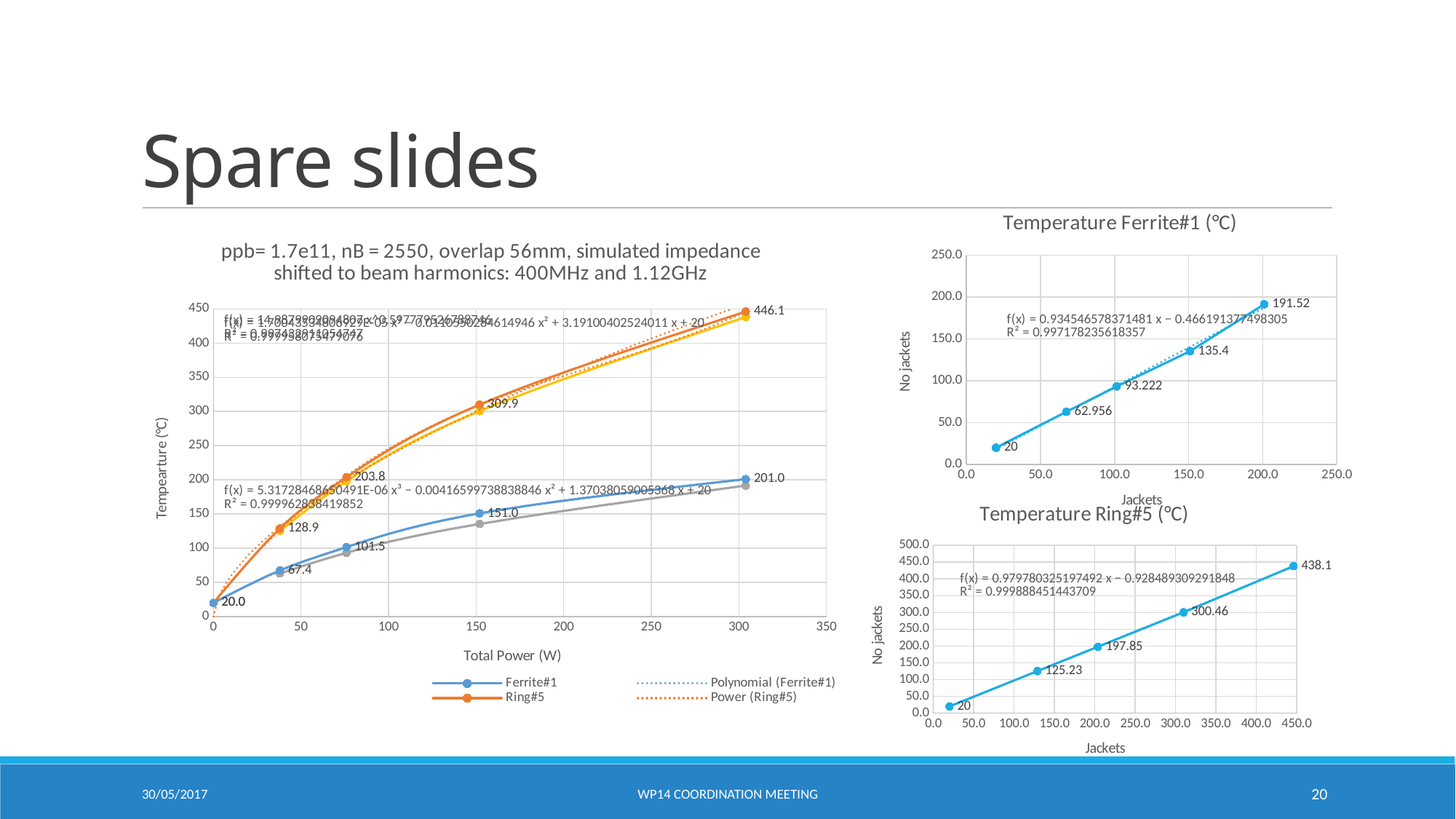
In the chart titled "Temperature Ring#5 (°C)", what is the highest labelled value? 438.1 In the left chart (ppb= 1.7e11, nB = 2550 ...), which series reaches the higher temperature at the highest total power, Ring#5 or Ferrite#1? Ring#5 In the chart titled "Temperature Ferrite#1 (°C)", what is the difference between the two highest labelled values, 191.52 and 135.4? 56.12 In the chart titled "Temperature Ring#5 (°C)", what is the lowest labelled value? 20 In the chart titled "Temperature Ring#5 (°C)", do the values rise or fall as the x-axis value increases? Rise In the left chart (ppb= 1.7e11, nB = 2550 ...), what is the difference between the highest labelled Ring#5 value (446.1) and the highest labelled Ferrite#1 value (201.0)? 245.1 In the left chart (ppb= 1.7e11, nB = 2550 ...), what is the highest labelled value for the Ring#5 series? 446.1 In the left chart (ppb= 1.7e11, nB = 2550 ...), what is the highest labelled value for the Ferrite#1 series? 201.0 What kind of chart is the left chart (ppb= 1.7e11, nB = 2550 ...)? Line chart How many entries does the legend of the left chart (ppb= 1.7e11, nB = 2550 ...) list? 4 How many data points are plotted in the chart titled "Temperature Ferrite#1 (°C)"? 5 In the chart titled "Temperature Ferrite#1 (°C)", what is the highest labelled value? 191.52